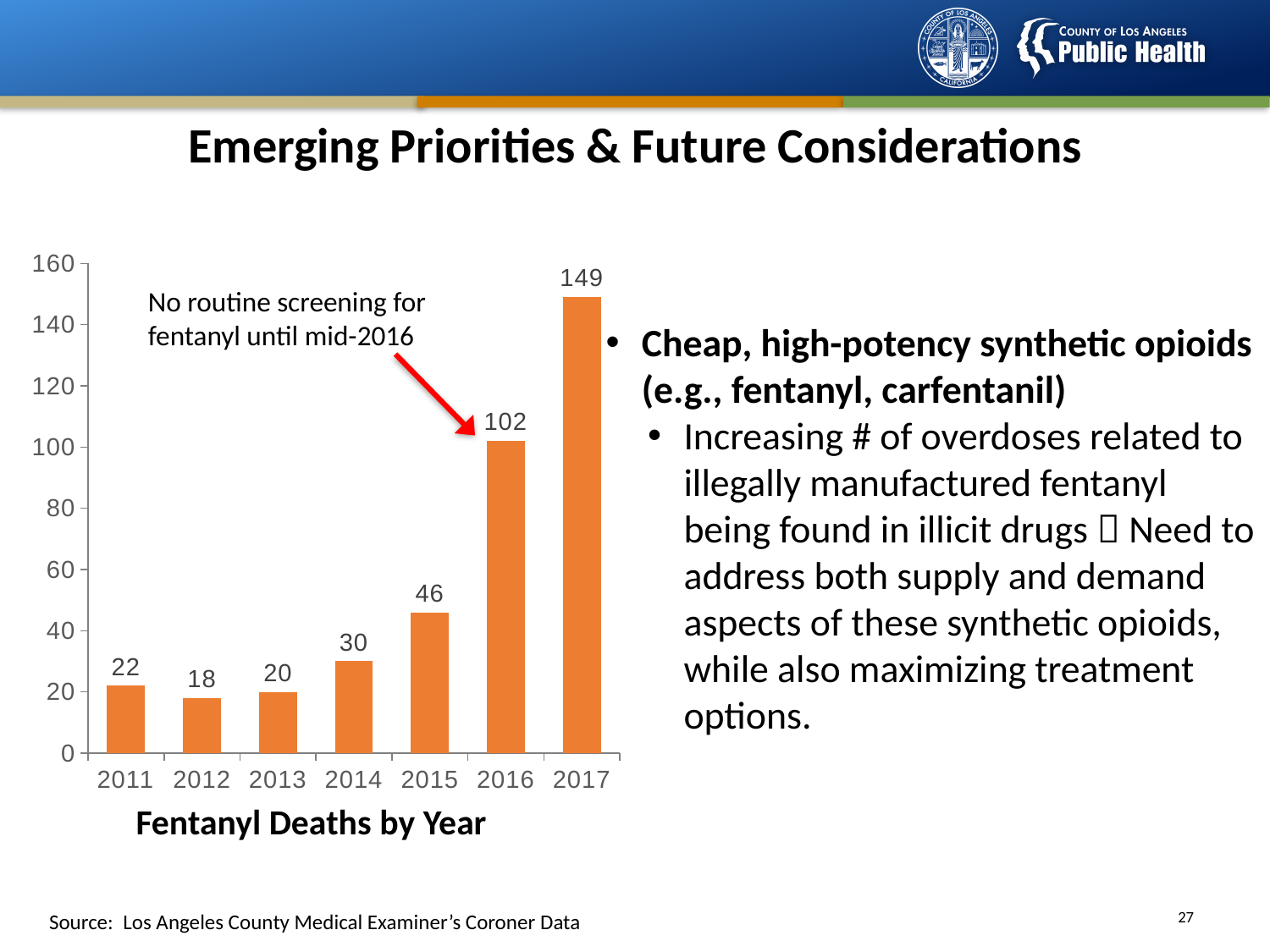
What is the difference in fentanyl deaths between 2015 and 2014? 16 Which year had more fentanyl deaths, 2011 or 2013? 2011 What is the highest value shown on the chart's vertical axis? 160 Do fentanyl deaths generally rise or fall from 2013 to 2017? Rise What kind of chart is used to show fentanyl deaths by year? Bar chart What is the number of fentanyl deaths shown for 2016? 102 What is the title of the chart? Fentanyl Deaths by Year Which year has the lowest number of fentanyl deaths? 2012 How many years are shown on the x axis of the chart? 7 What is the number of fentanyl deaths shown for 2012? 18 What is the difference in fentanyl deaths between 2017 and 2016? 47 Which year has the highest number of fentanyl deaths? 2017